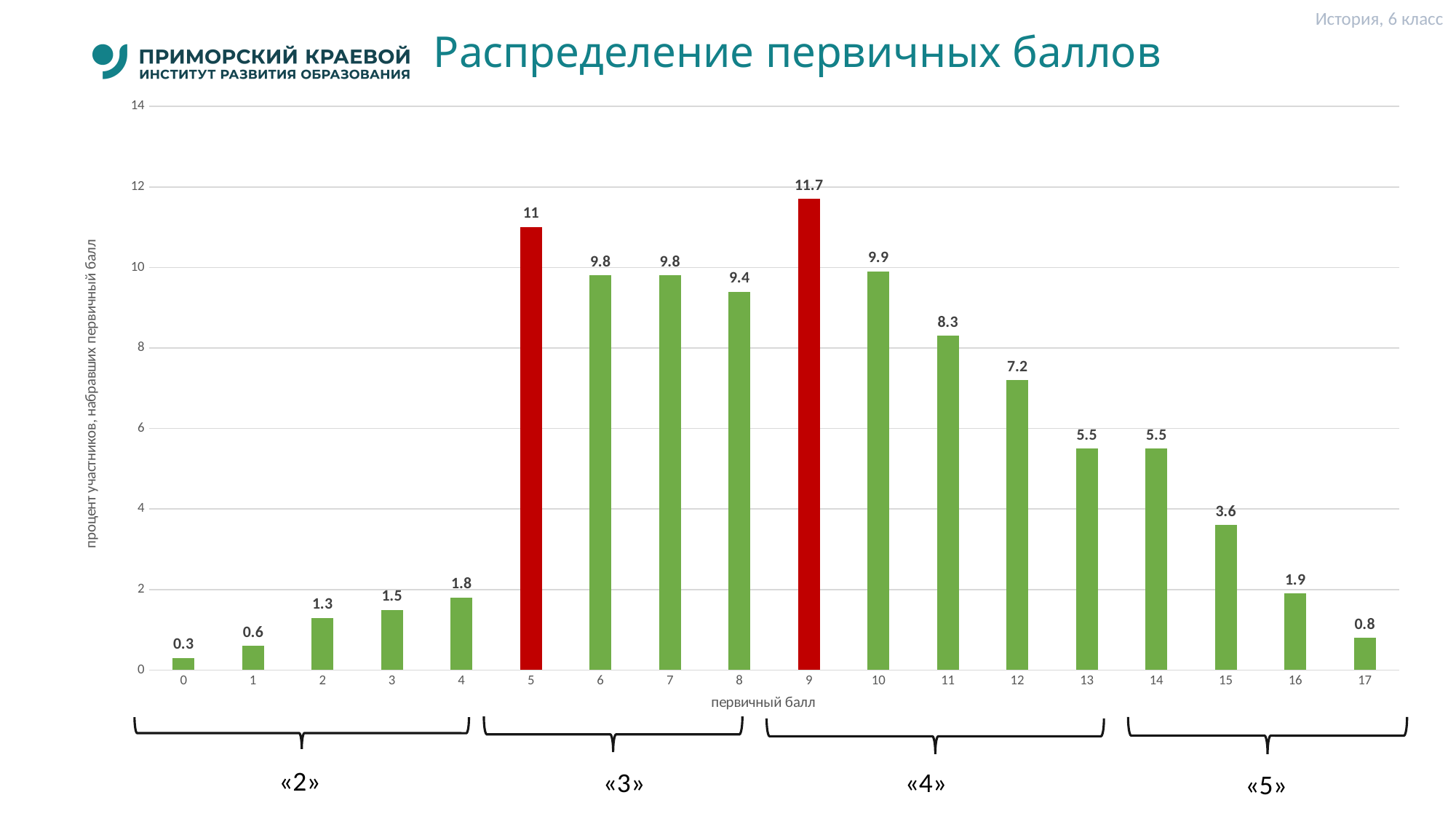
Is the value for primary score 8 greater or less than 10? less Which primary score has the highest value? 9 What is the difference between the values for primary scores 9 and 5? 0.7 What is the difference between the values for primary scores 12 and 13? 1.7 How many primary score categories are shown on the x axis? 18 What is the value for primary score 15? 3.6 Which is larger, the value for primary score 10 or for primary score 11? 10 What is the value for primary score 5? 11 What kind of chart is shown on the slide? bar chart Which primary score has the lowest value? 0 Which bars are coloured red? 5 and 9 What is the value for primary score 9? 11.7